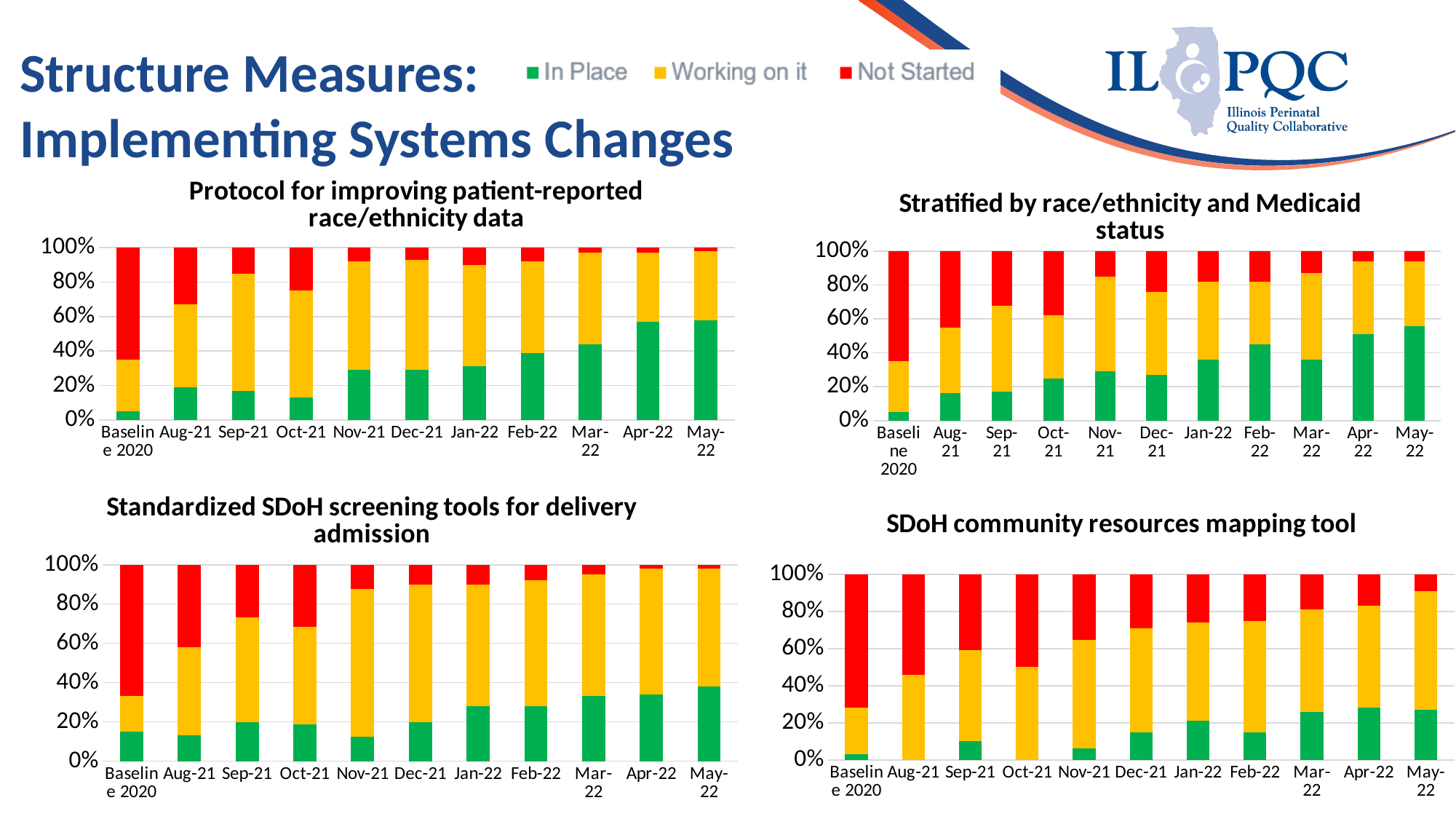
In the "Stratified by race/ethnicity and Medicaid status" chart, does the In Place share rise or fall from Baseline 2020 to May-22? rise How many series does the legend at the top of the slide list? 3 In the "Standardized SDoH screening tools for delivery admission" chart, is the Not Started share for Baseline 2020 greater or less than 60%? greater In the "SDoH community resources mapping tool" chart, is the Not Started share larger for Baseline 2020 or for May-22? Baseline 2020 What kind of chart is the "Protocol for improving patient-reported race/ethnicity data" chart? bar chart How many time periods are shown on the x axis of the "SDoH community resources mapping tool" chart? 11 In the "Protocol for improving patient-reported race/ethnicity data" chart, is the In Place share for May-22 greater or less than 40%? greater In the "Protocol for improving patient-reported race/ethnicity data" chart, which period has the smallest In Place share? Baseline 2020 In the "Stratified by race/ethnicity and Medicaid status" chart, which period has the largest Not Started share? Baseline 2020 What are the three legend entries shown at the top of the slide? In Place, Working on it, Not Started In the "SDoH community resources mapping tool" chart, is the In Place share for Baseline 2020 greater or less than 20%? less In the "Stratified by race/ethnicity and Medicaid status" chart, which period has the largest In Place share? May-22